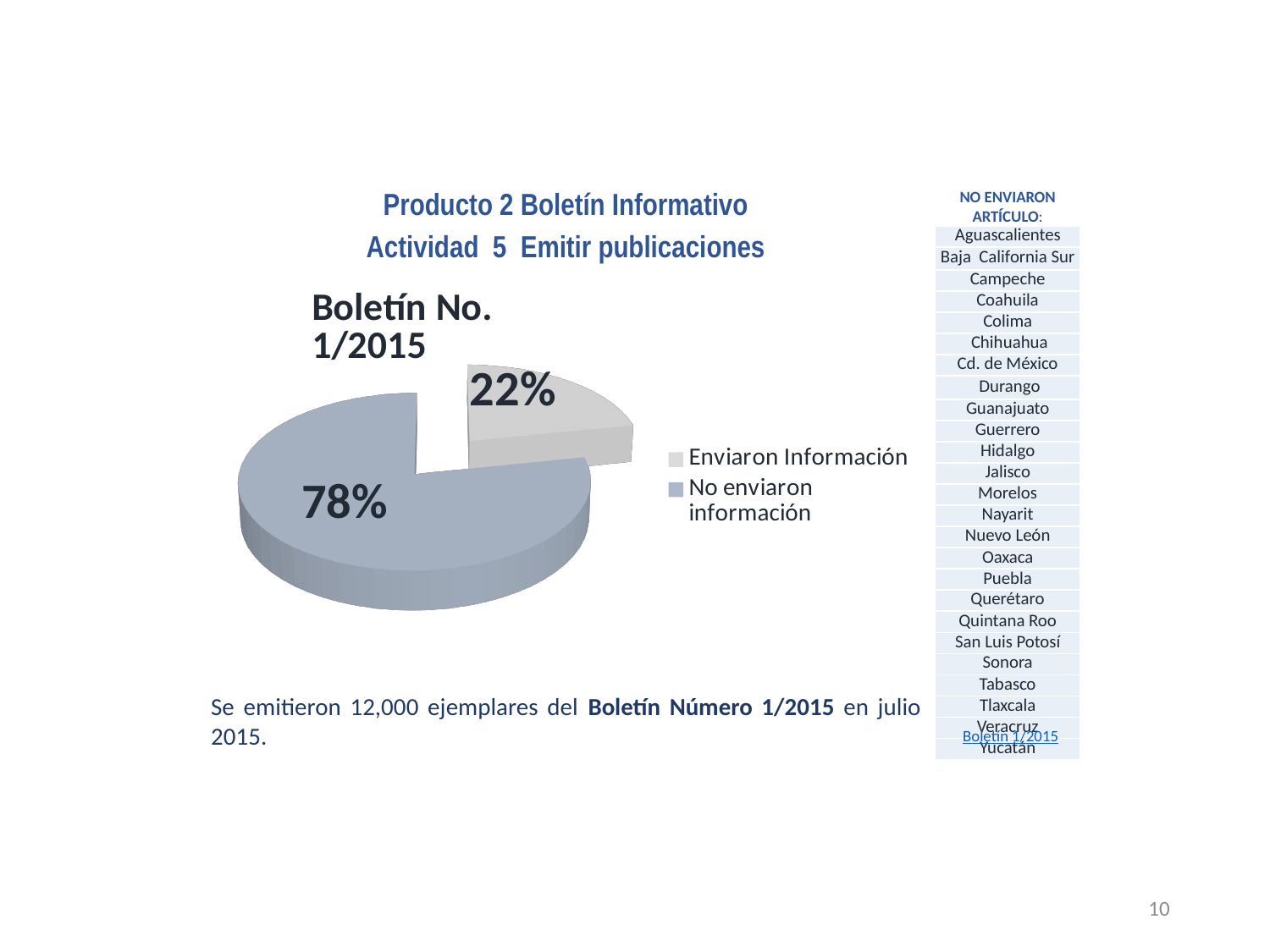
What percentage of the pie is labelled 'Enviaron Información'? 22% What is the title of the pie chart? Boletín No. 1/2015 What share of the pie does the 'No enviaron información' slice represent? 78% Which slice of the pie chart is the smallest? Enviaron Información Which slice of the pie chart is the largest? No enviaron información Which legend entry is shown in the light grey colour? Enviaron Información What kind of chart is shown on the slide? Pie chart What percentage of the pie is labelled 'No enviaron información'? 78% How many slices does the pie chart have? 2 How many entries does the legend of the pie chart list? 2 Which is larger: the 'Enviaron Información' slice or the 'No enviaron información' slice? No enviaron información What is the difference in percentage points between the 'No enviaron información' slice and the 'Enviaron Información' slice? 56